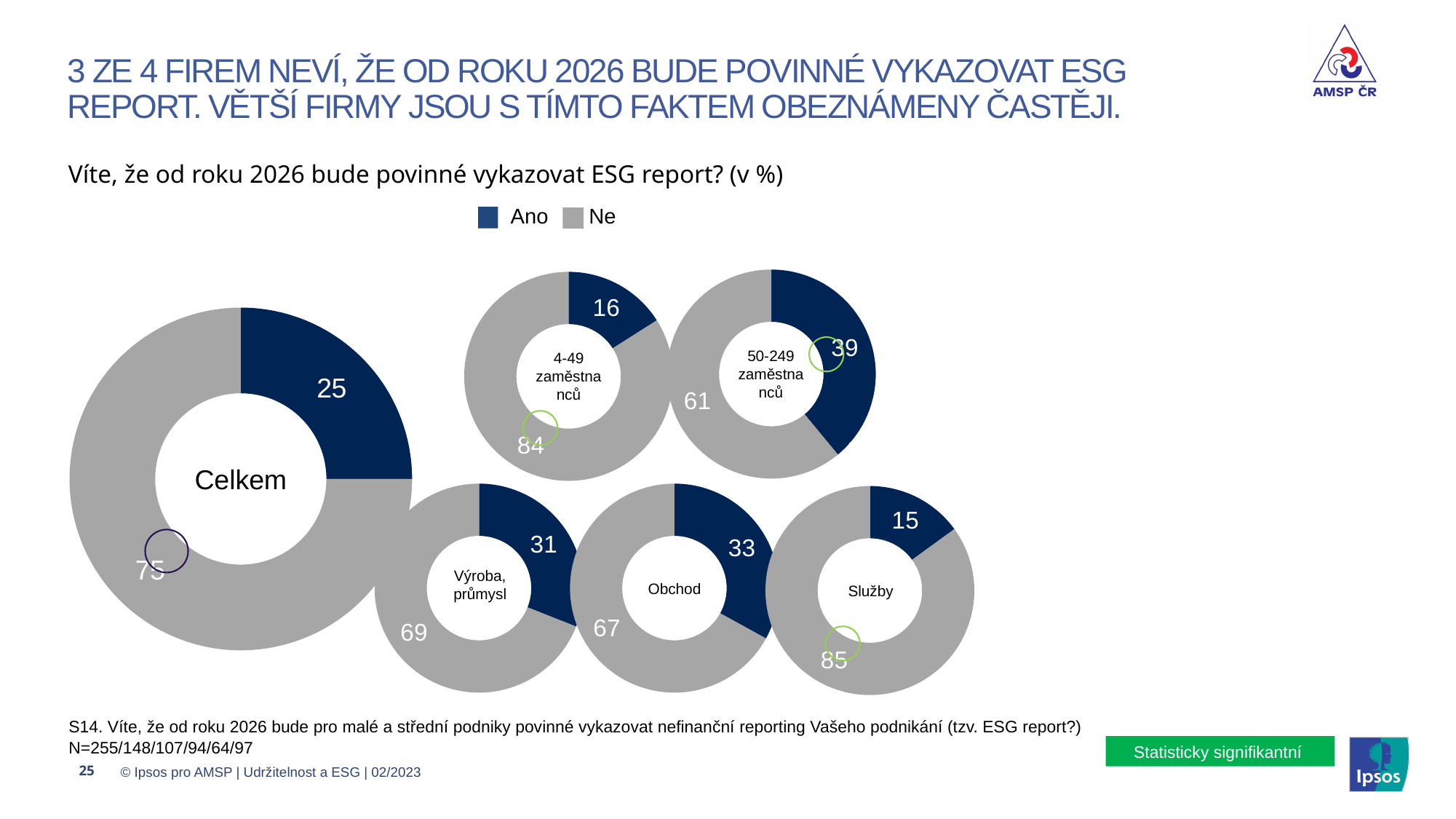
What type of chart is used on the slide? Donut chart How many series does the legend list? 2 How many donut charts are shown on the slide? 6 In the 'Celkem' donut chart, what is the value for 'Ano'? 25 In the '4-49 zaměstnanců' donut chart, what is the value for 'Ano'? 16 Across the donut charts on the slide, which group has the lowest 'Ano' value? Služby Which has a larger 'Ano' value: the 'Obchod' chart or the 'Výroba, průmysl' chart? Obchod In the 'Celkem' donut chart, what is the value for 'Ne'? 75 In the '50-249 zaměstnanců' donut chart, what is the value for 'Ne'? 61 What is the difference between the 'Ano' value in the '50-249 zaměstnanců' chart and the 'Ano' value in the '4-49 zaměstnanců' chart? 23 Across the donut charts on the slide, which group has the highest 'Ano' value? 50-249 zaměstnanců In the 'Služby' donut chart, what is the value for 'Ne'? 85